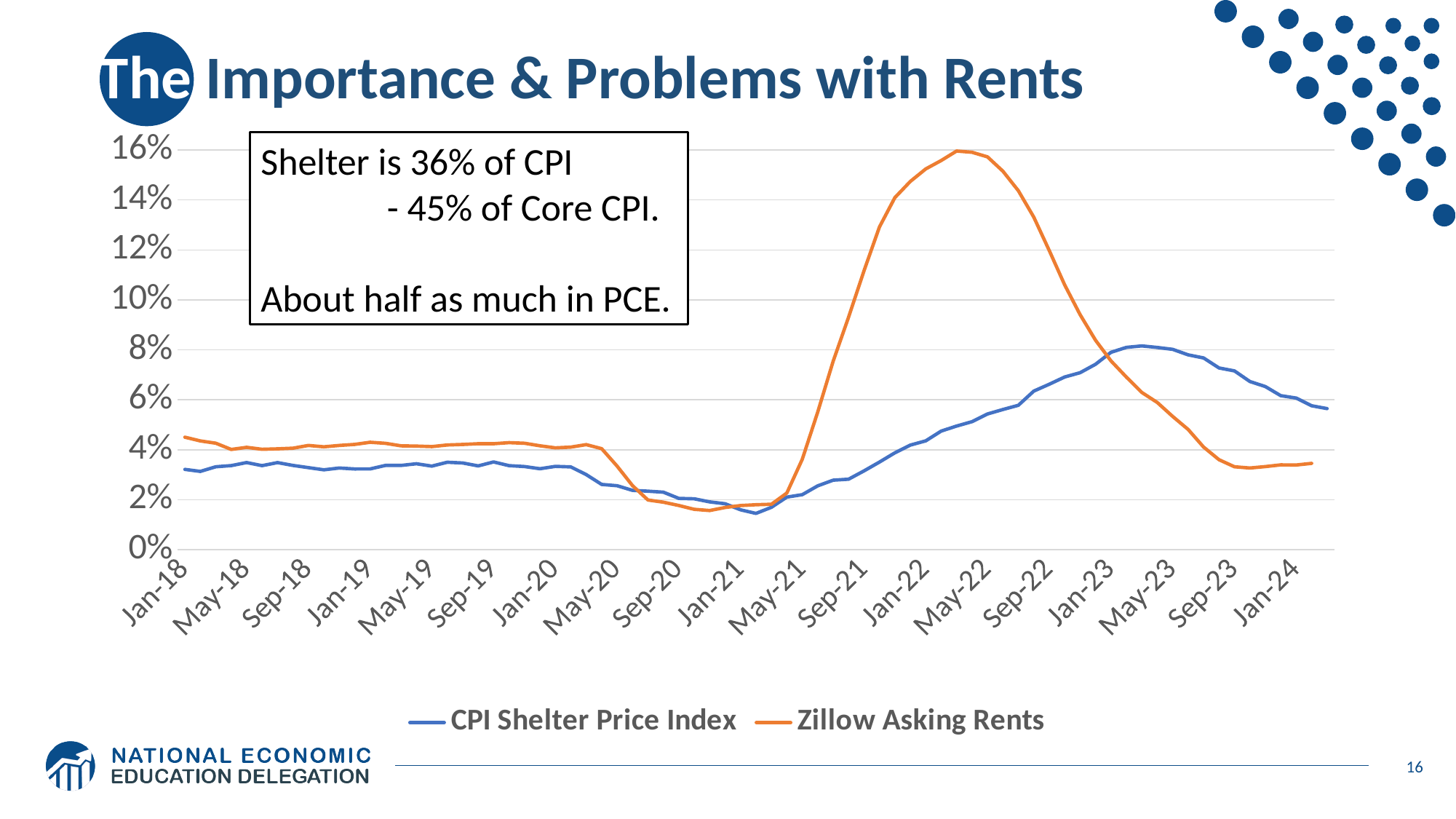
At May-22, which series has the higher value, CPI Shelter Price Index or Zillow Asking Rents? Zillow Asking Rents Is the value for Zillow Asking Rents at Jan-21 greater or less than 2%? less Is the value for CPI Shelter Price Index at Jan-18 greater or less than 4%? less Is the value for Zillow Asking Rents at May-22 greater or less than 14%? greater What kind of chart is shown on the slide? Line chart Do the values for Zillow Asking Rents rise or fall between May-22 and Sep-23? fall Which series reaches the highest peak on the chart? Zillow Asking Rents How many series does the legend list? 2 Which series is drawn in orange? Zillow Asking Rents At Jan-24, which series has the higher value, CPI Shelter Price Index or Zillow Asking Rents? CPI Shelter Price Index How many date labels are shown on the x axis? 19